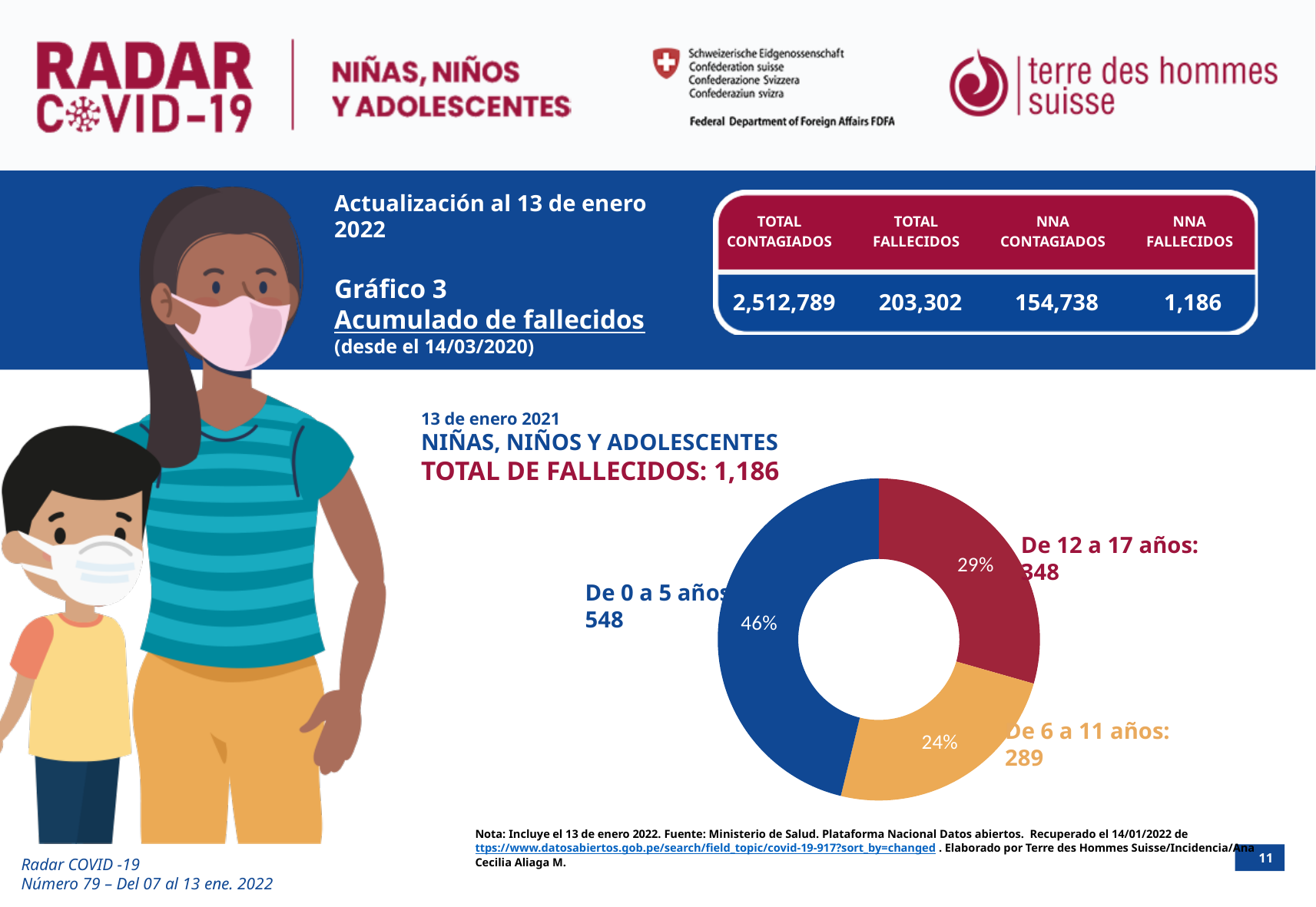
How many age groups are shown in the pie chart? 3 What colour is the slice for 'De 0 a 5 años'? blue What kind of chart is shown on the slide? pie (donut) chart What percentage of the pie does 'De 6 a 11 años' represent? 24% Which age group has the smallest share of the pie? De 6 a 11 años What percentage of the pie does 'De 0 a 5 años' represent? 46% What is the total number of deaths shown above the pie chart? 1,186 Which age group has the largest share of the pie? De 0 a 5 años How many deaths are shown for the group 'De 6 a 11 años'? 289 What percentage of the pie does 'De 12 a 17 años' represent? 29% What is the difference in deaths between 'De 0 a 5 años' and 'De 6 a 11 años'? 259 How many deaths are shown for the group 'De 0 a 5 años'? 548